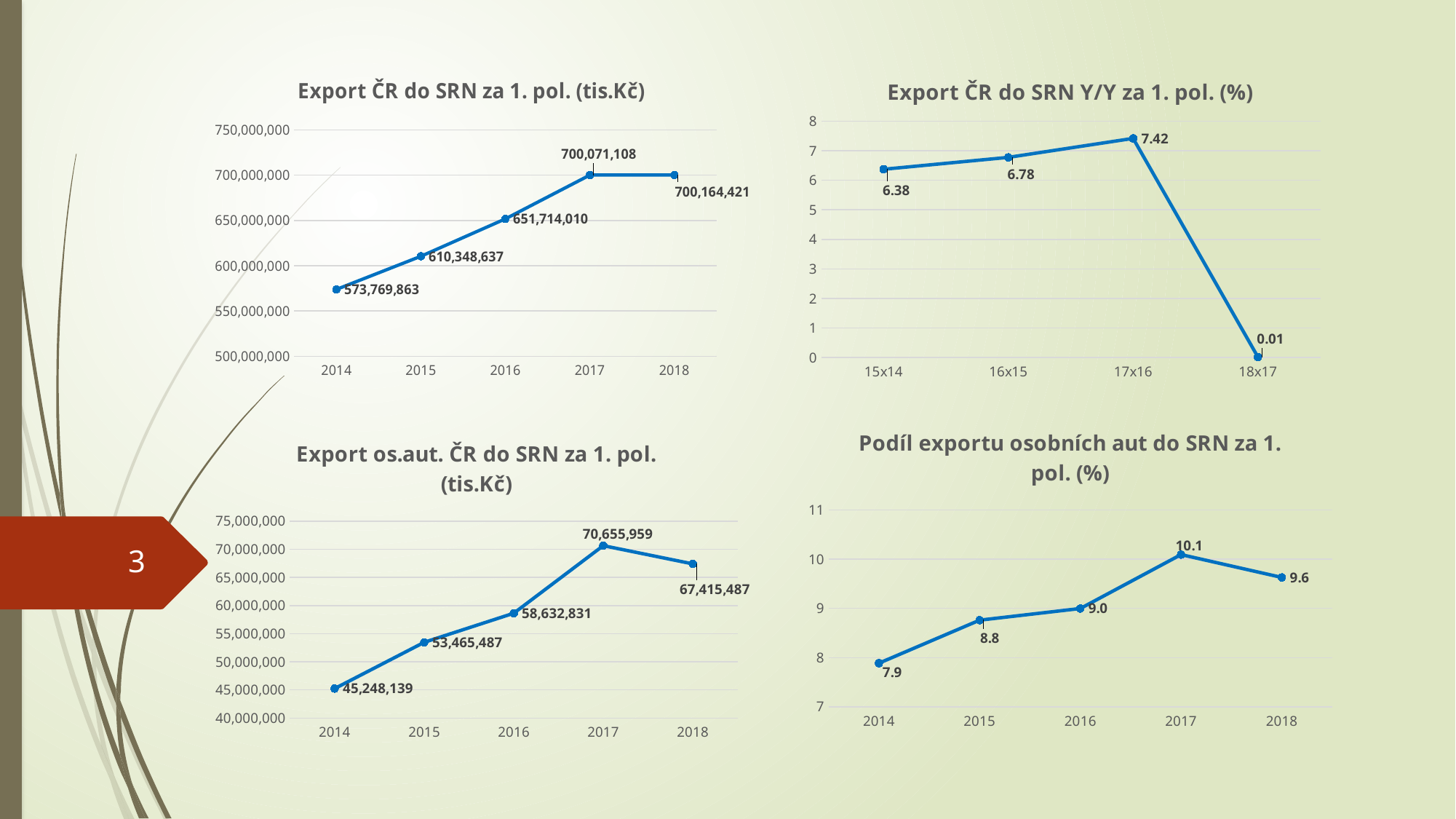
In the chart titled 'Export os.aut. ČR do SRN za 1. pol. (tis.Kč)', which year has the highest value? 2017 In the chart titled 'Export ČR do SRN Y/Y za 1. pol. (%)', how many data points are plotted? 4 In the chart titled 'Podíl exportu osobních aut do SRN za 1. pol. (%)', what is the difference between the 2017 and 2014 values? 2.2 In the chart titled 'Export ČR do SRN za 1. pol. (tis.Kč)', what is the difference between the 2015 and 2014 values? 36,578,774 In the chart titled 'Export os.aut. ČR do SRN za 1. pol. (tis.Kč)', is the value for 2017 larger than the value for 2018? Yes In the chart titled 'Export ČR do SRN za 1. pol. (tis.Kč)', what is the value for 2016? 651,714,010 What type of chart is the chart titled 'Podíl exportu osobních aut do SRN za 1. pol. (%)'? Line chart In the chart titled 'Export ČR do SRN Y/Y za 1. pol. (%)', which category has the lowest value? 18x17 In the chart titled 'Export os.aut. ČR do SRN za 1. pol. (tis.Kč)', what is the value for 2018? 67,415,487 In the chart titled 'Export ČR do SRN za 1. pol. (tis.Kč)', which year has the lowest value? 2014 In the chart titled 'Export ČR do SRN Y/Y za 1. pol. (%)', what is the value for 17x16? 7.42 In the chart titled 'Podíl exportu osobních aut do SRN za 1. pol. (%)', what is the value for 2015? 8.8